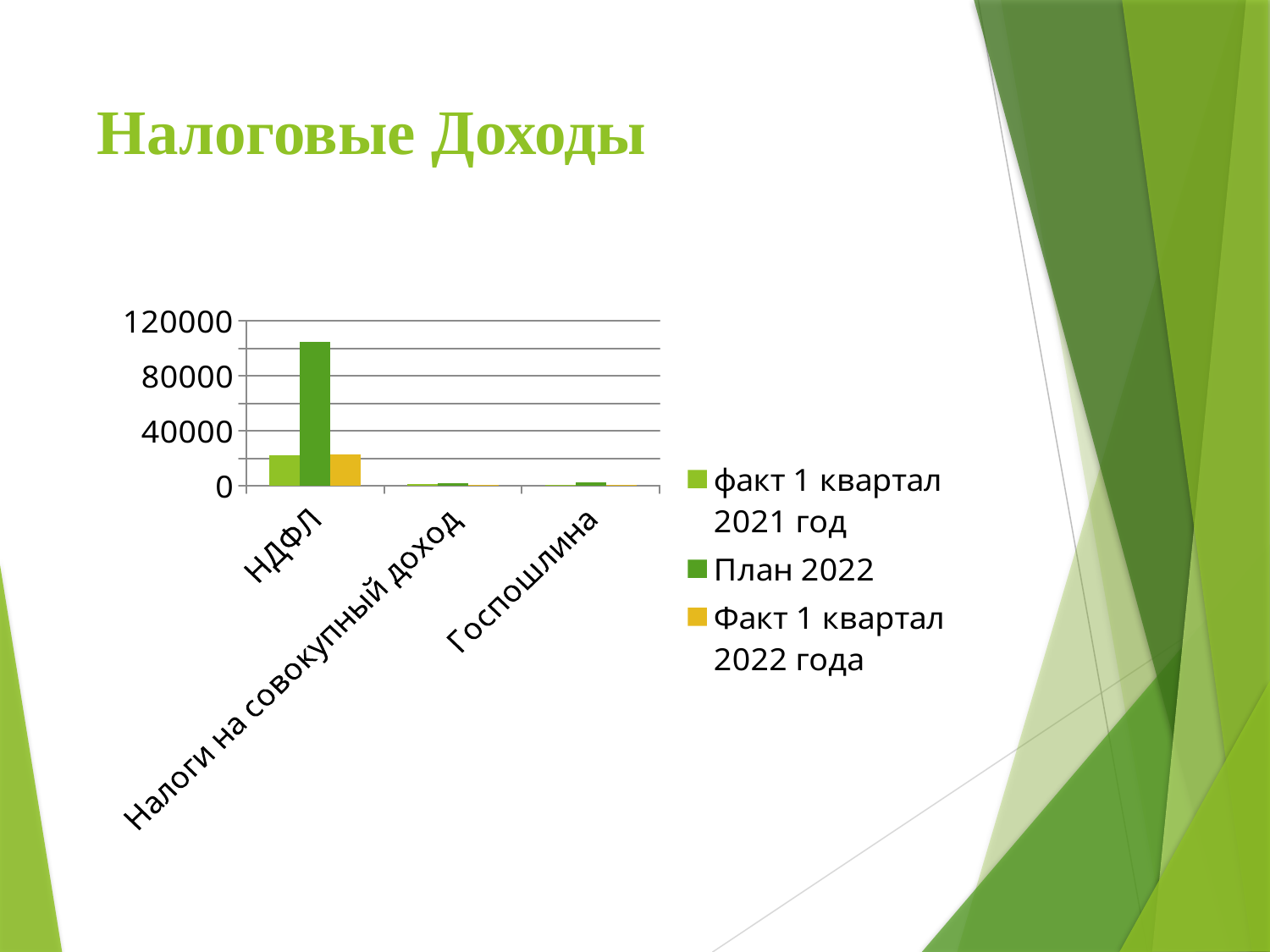
Is the План 2022 value for Госпошлина greater or less than 40000? less Which series is shown in yellow in the chart legend? Факт 1 квартал 2022 года How many series does the chart legend list? 3 Which category has the highest value for the План 2022 series? НДФЛ Is the факт 1 квартал 2021 год value for НДФЛ greater or less than 40000? less Which category has the lowest value for the План 2022 series? Налоги на совокупный доход What is the title of the slide containing the chart? Налоговые Доходы For НДФЛ, which is larger: the План 2022 value or the факт 1 квартал 2021 год value? План 2022 Is the План 2022 value for НДФЛ greater or less than 80000? greater What kind of chart is shown on the slide? bar chart How many categories are shown on the x axis of the chart? 3